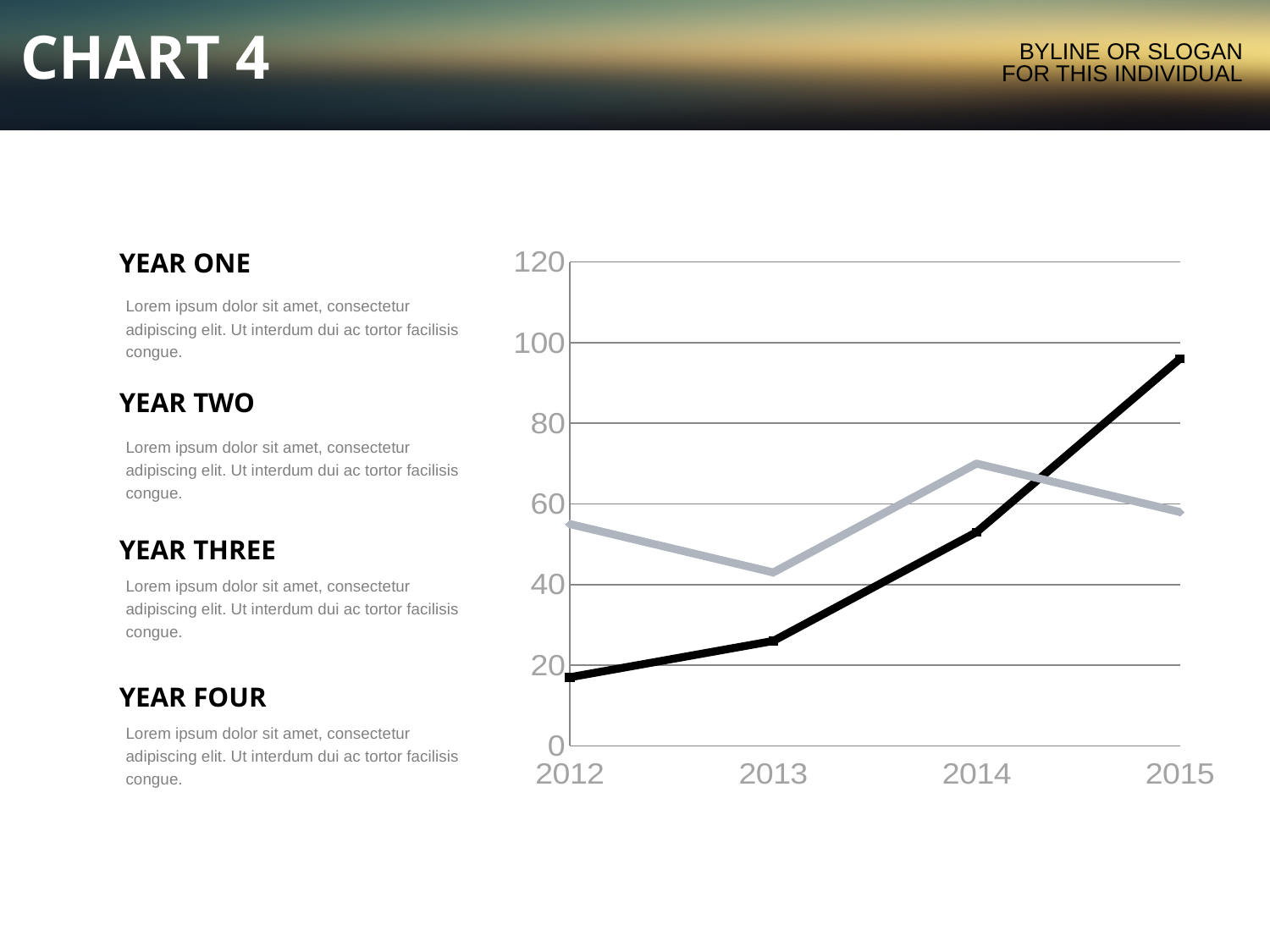
What kind of chart is shown on the slide? line chart Is the value of the black line in 2012 greater or less than 20? less Is the value of the black line in 2015 greater or less than 80? greater How many lines are plotted on the chart? 2 Is the value of the gray line in 2014 greater or less than 60? greater In 2013, which line has the higher value, the black line or the gray line? gray line How many years are shown along the x axis of the chart? 4 Does the black line rise or fall from 2012 to 2015? rise In which year does the black line reach its highest value? 2015 In which year does the gray line reach its lowest value? 2013 In 2015, which line has the higher value, the black line or the gray line? black line